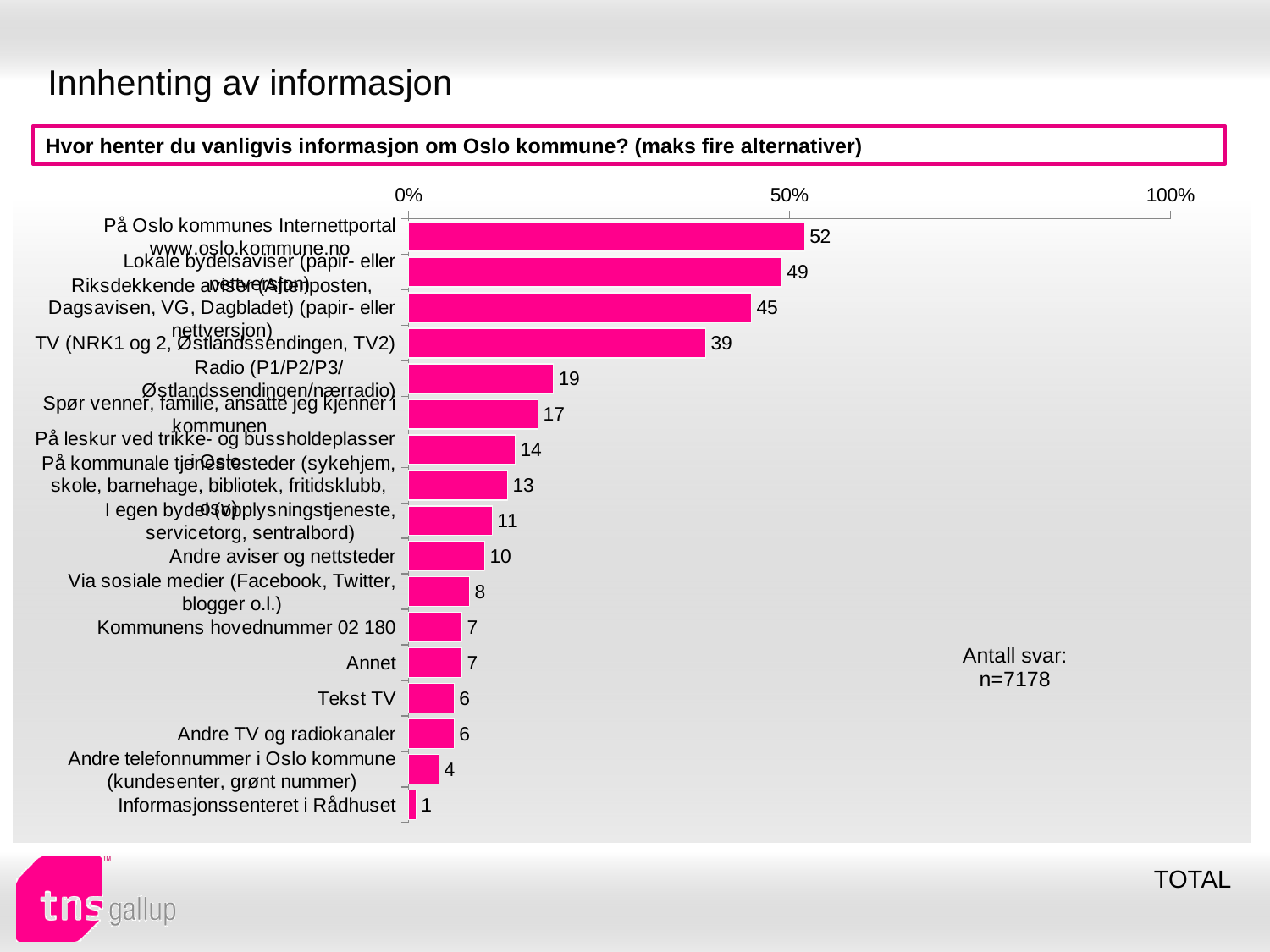
What is the number of respondents (n) stated on the slide? n=7178 What is the value for "Tekst TV"? 6 Which category has the lowest value? Informasjonssenteret i Rådhuset Is the value for "På Oslo kommunes Internettportal www.oslo.kommune.no" greater or less than 50%? greater Which category has the highest value? På Oslo kommunes Internettportal www.oslo.kommune.no What is the value for "Andre aviser og nettsteder"? 10 What kind of chart is shown on the slide? bar chart How many categories are shown in the chart? 17 What is the value for "Kommunens hovednummer 02 180"? 7 What is the difference between the value for "Andre aviser og nettsteder" and the value for "Tekst TV"? 4 What is the value for "Informasjonssenteret i Rådhuset"? 1 Which is larger: the value for "Annet" or the value for "Andre TV og radiokanaler"? Annet